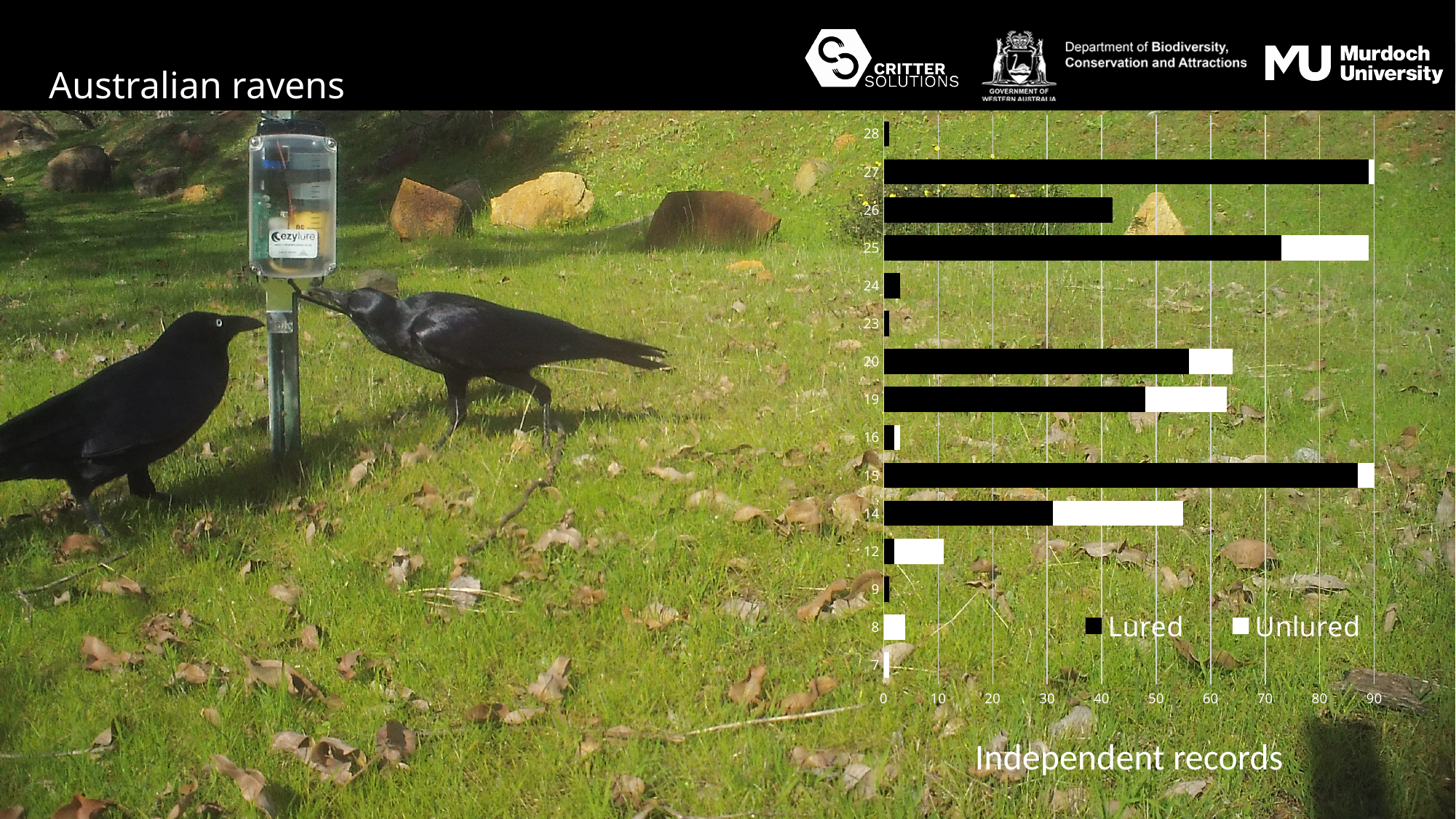
Is the Lured value for category 25 greater or less than 60? greater Is the Lured value for category 27 greater or less than 80? greater Which category has the largest Unlured segment? 14 What are the two series named in the chart's legend? Lured and Unlured Which has the larger Lured value, category 26 or category 14? 26 Is the Lured value for category 26 greater or less than 50? less What kind of chart is shown on the slide? bar chart What is the title of the chart's horizontal axis? Independent records How many series does the chart's legend list? 2 How many categories are plotted on the chart's vertical axis? 15